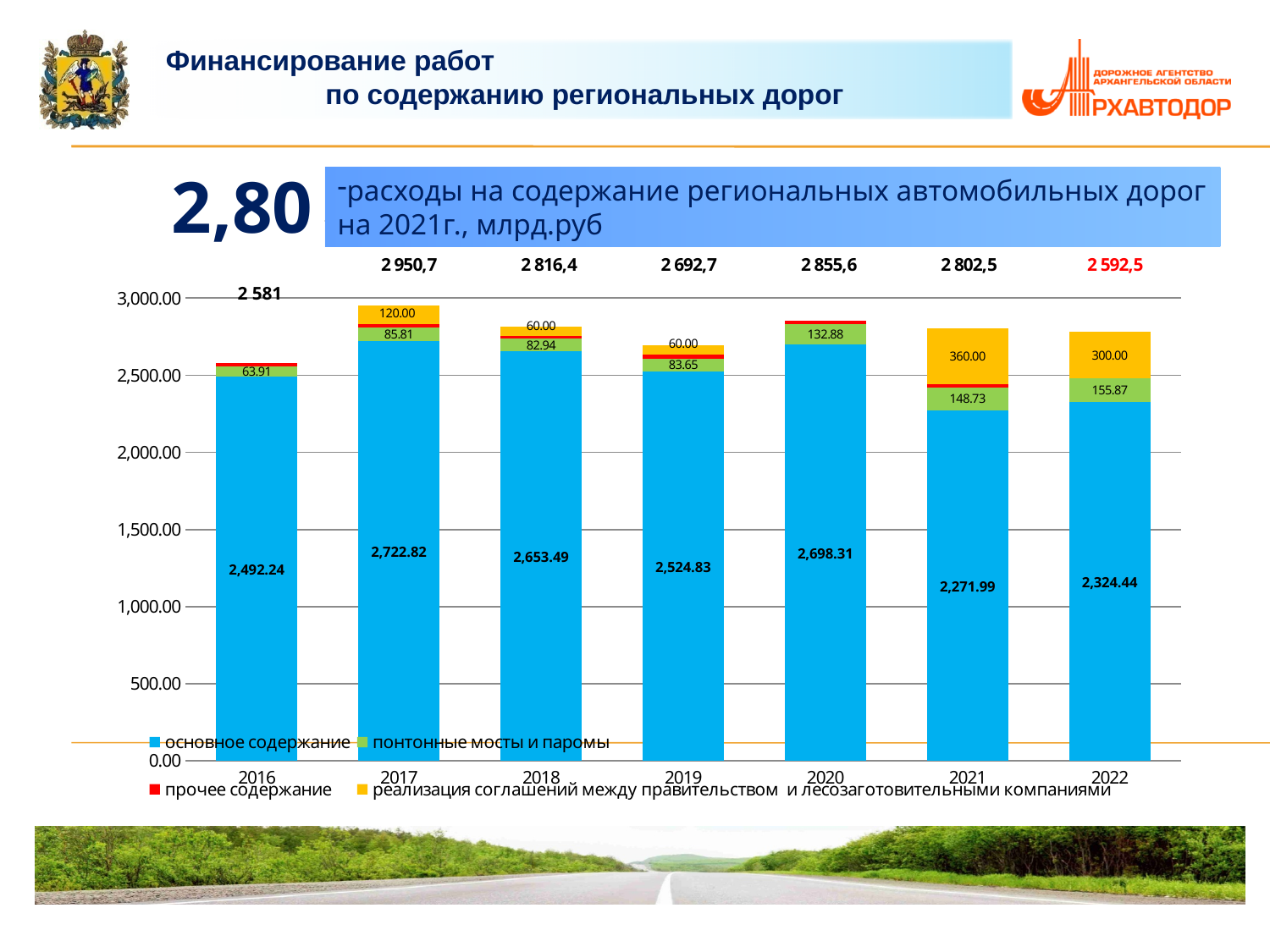
Which is larger: the "понтонные мосты и паромы" value for 2022 or for 2016? 2022 In which year is the value of "основное содержание" the lowest? 2021 Is the value of "основное содержание" for 2022 greater or less than 2,500.00? less What is the value of "реализация соглашений между правительством и лесозаготовительными компаниями" for 2021? 360.00 Which colour represents "прочее содержание" in the chart legend? red How many series does the chart legend list? 4 What is the total shown above the bar for 2019? 2 692,7 What is the value of "понтонные мосты и паромы" for 2020? 132.88 How many years (categories) are shown on the x axis of the chart? 7 In which year is the value of "основное содержание" the highest? 2017 What type of chart is shown on the slide? bar chart What is the value of "основное содержание" for 2017? 2,722.82